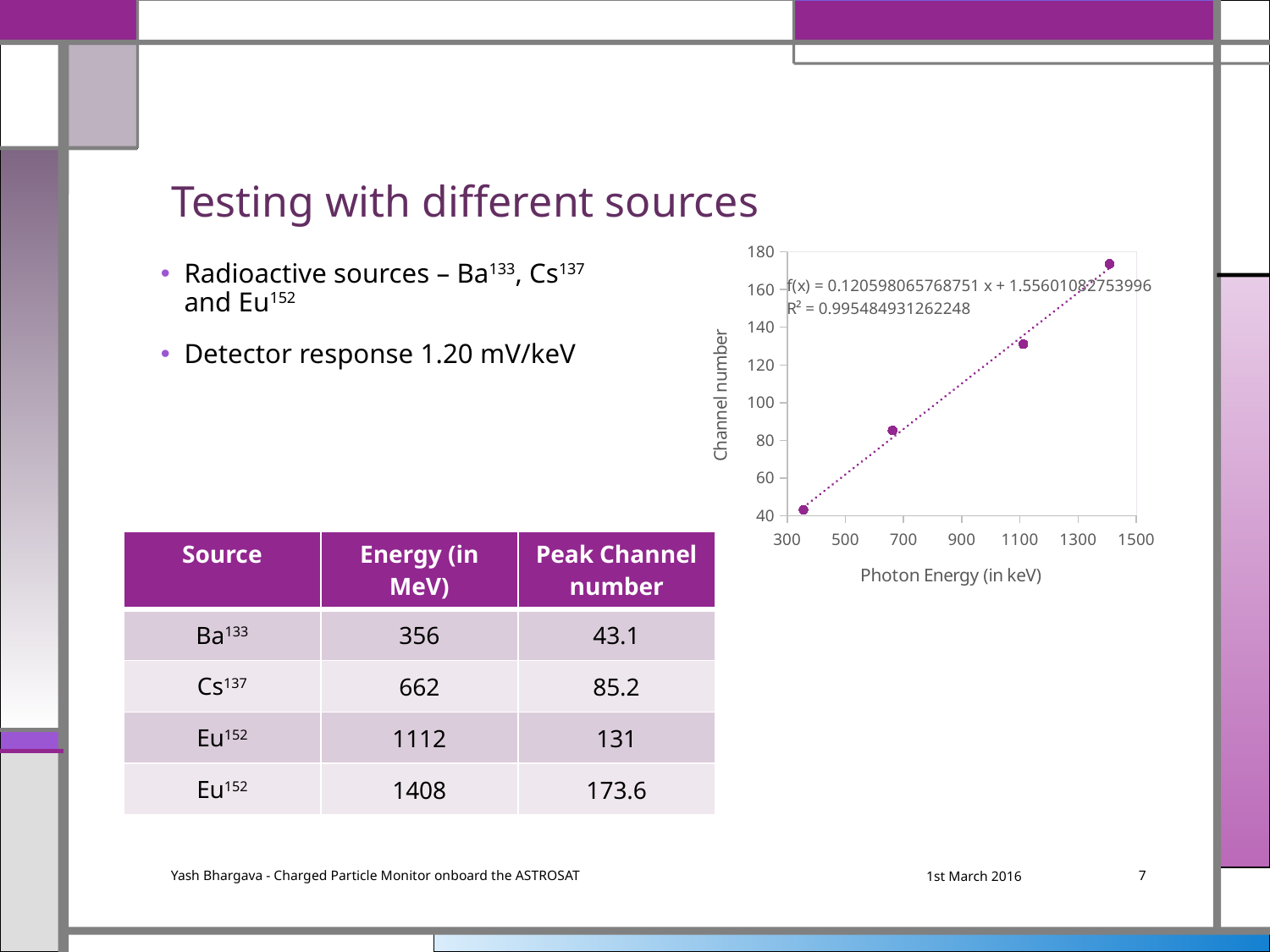
How many data points are plotted on the chart? 4 Is the channel number for the data point just below 700 keV greater or less than 100? less Is the channel number for the leftmost data point (lowest photon energy) greater or less than 60? less Which data point has the highest channel number, the leftmost or the rightmost? the rightmost What R² value is printed on the chart for the trendline? R² = 0.995484931262248 Is the channel number for the data point just above 1100 keV greater or less than 140? less What kind of chart is shown on the slide? scatter chart Do the channel number values rise or fall as photon energy increases along the x axis? rise What is the title of the x axis of the chart? Photon Energy (in keV)